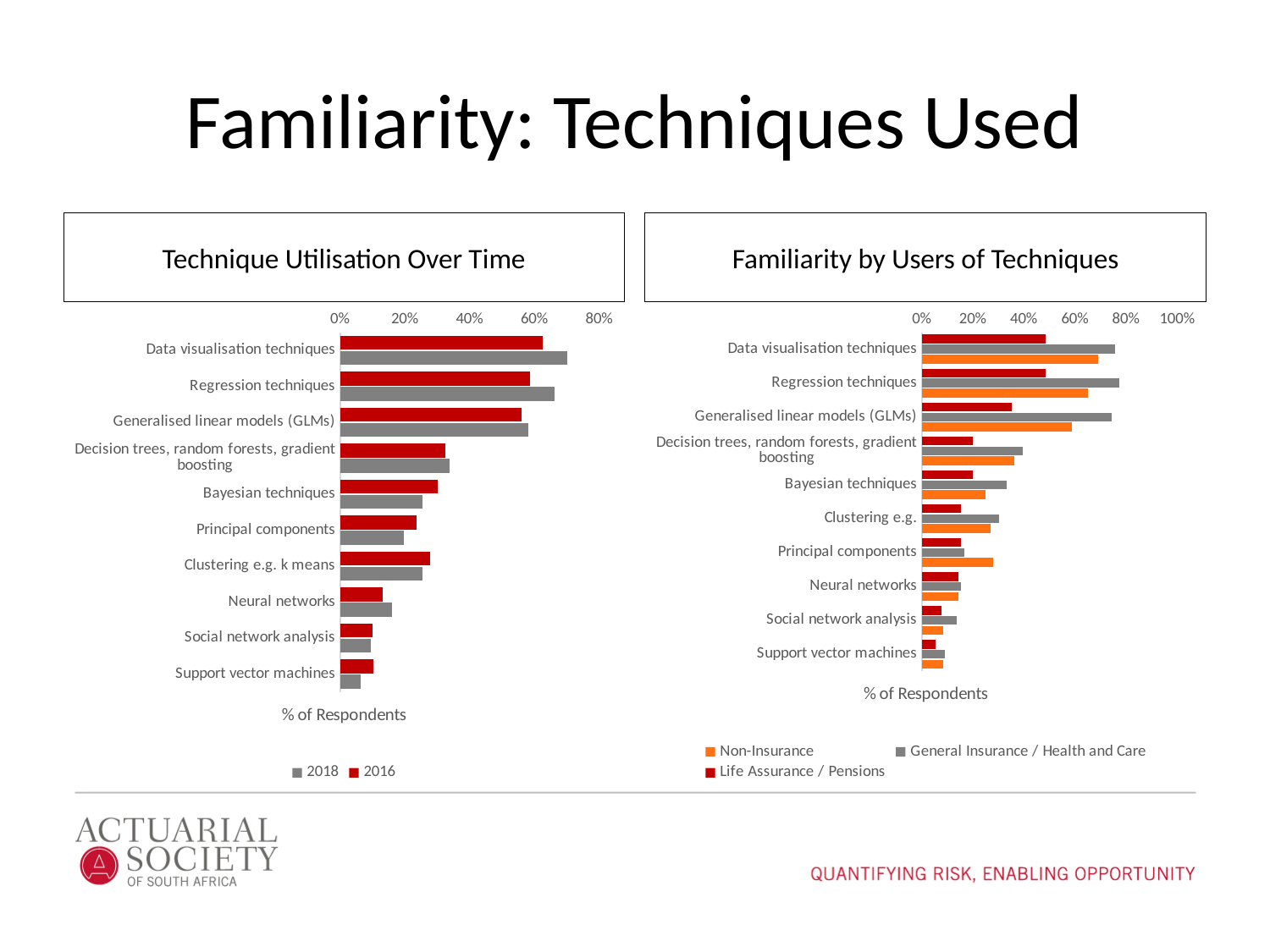
In the 'Familiarity by Users of Techniques' chart, is the General Insurance / Health and Care value for Regression techniques greater or less than 60%? greater In the 'Technique Utilisation Over Time' chart, is the 2018 value for Data visualisation techniques greater or less than 60%? greater In the 'Familiarity by Users of Techniques' chart, which technique has the lowest Life Assurance / Pensions value? Support vector machines How many series does the legend of the 'Technique Utilisation Over Time' chart list? 2 In the 'Technique Utilisation Over Time' chart, which technique has the highest 2018 value? Data visualisation techniques In the 'Technique Utilisation Over Time' chart, for Data visualisation techniques, which year has the larger value, 2018 or 2016? 2018 How many series does the legend of the 'Familiarity by Users of Techniques' chart list? 3 In the 'Familiarity by Users of Techniques' chart, for Generalised linear models (GLMs), which is larger: General Insurance / Health and Care or Life Assurance / Pensions? General Insurance / Health and Care What is the axis label shown below the bars on the 'Familiarity by Users of Techniques' chart? % of Respondents What kind of chart is the 'Technique Utilisation Over Time' chart? bar chart How many techniques are listed on the 'Technique Utilisation Over Time' chart? 10 In the 'Technique Utilisation Over Time' chart, is the 2016 value for Neural networks greater or less than 20%? less